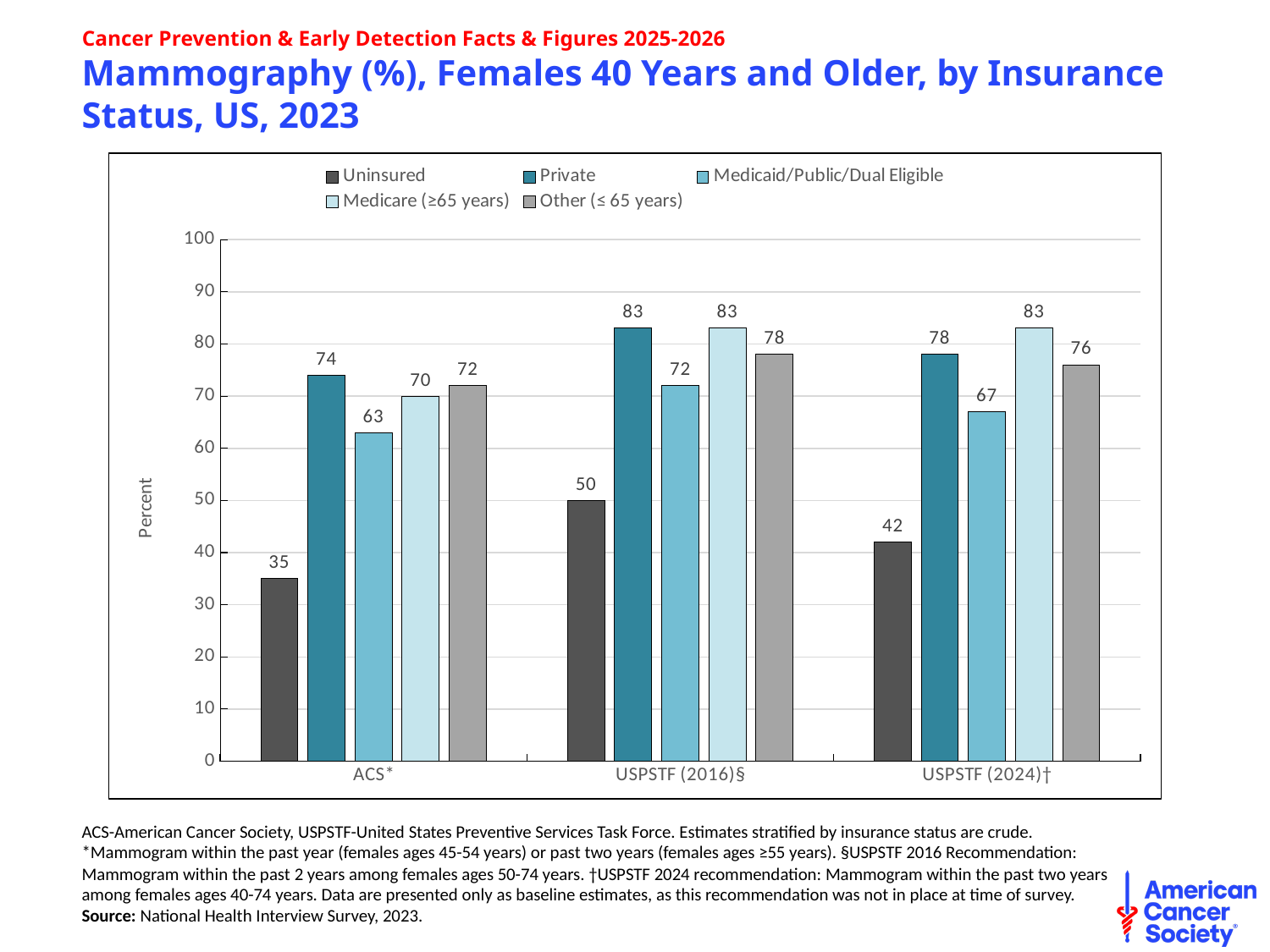
What is the value for Private in the USPSTF (2016)§ group? 83 Which insurance status has the highest value in the ACS* group? Private What is the value for Medicaid/Public/Dual Eligible in the USPSTF (2024)† group? 67 What is the label of the y axis? Percent What is the value for Other (≤ 65 years) in the ACS* group? 72 What is the value for Uninsured in the ACS* group? 35 Which is larger in the USPSTF (2024)† group: Private or Other (≤ 65 years)? Private What kind of chart is shown on the slide? Bar chart What is the difference between the Private and Uninsured values in the USPSTF (2016)§ group? 33 How many groups are shown on the x axis? 3 How many series does the legend list? 5 Which insurance status has the lowest value in the USPSTF (2024)† group? Uninsured